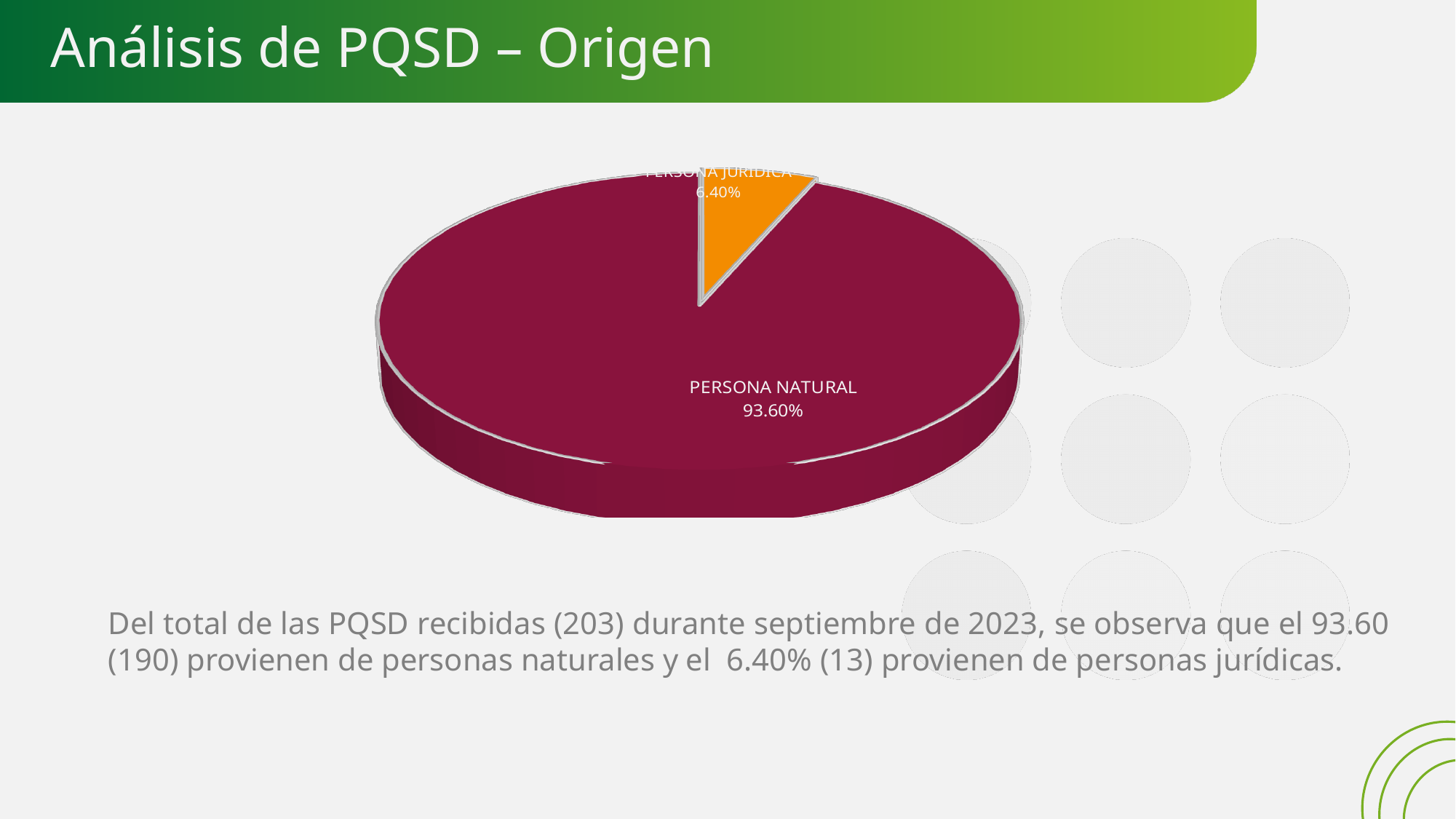
What share of the pie does PERSONA NATURAL represent? 93.60% What share of the pie does PERSONA JURÍDICA represent? 6.40% Which category has the smallest slice of the pie? PERSONA JURÍDICA What kind of chart is shown on the slide? Pie chart What colour is the PERSONA JURÍDICA slice? Orange Which slice is larger, PERSONA NATURAL or PERSONA JURÍDICA? PERSONA NATURAL How many categories are shown in the pie chart? 2 What is the title of the slide containing the chart? Análisis de PQSD – Origen What is the difference in percentage points between the PERSONA NATURAL and PERSONA JURÍDICA slices? 87.20% Which category has the largest slice of the pie? PERSONA NATURAL